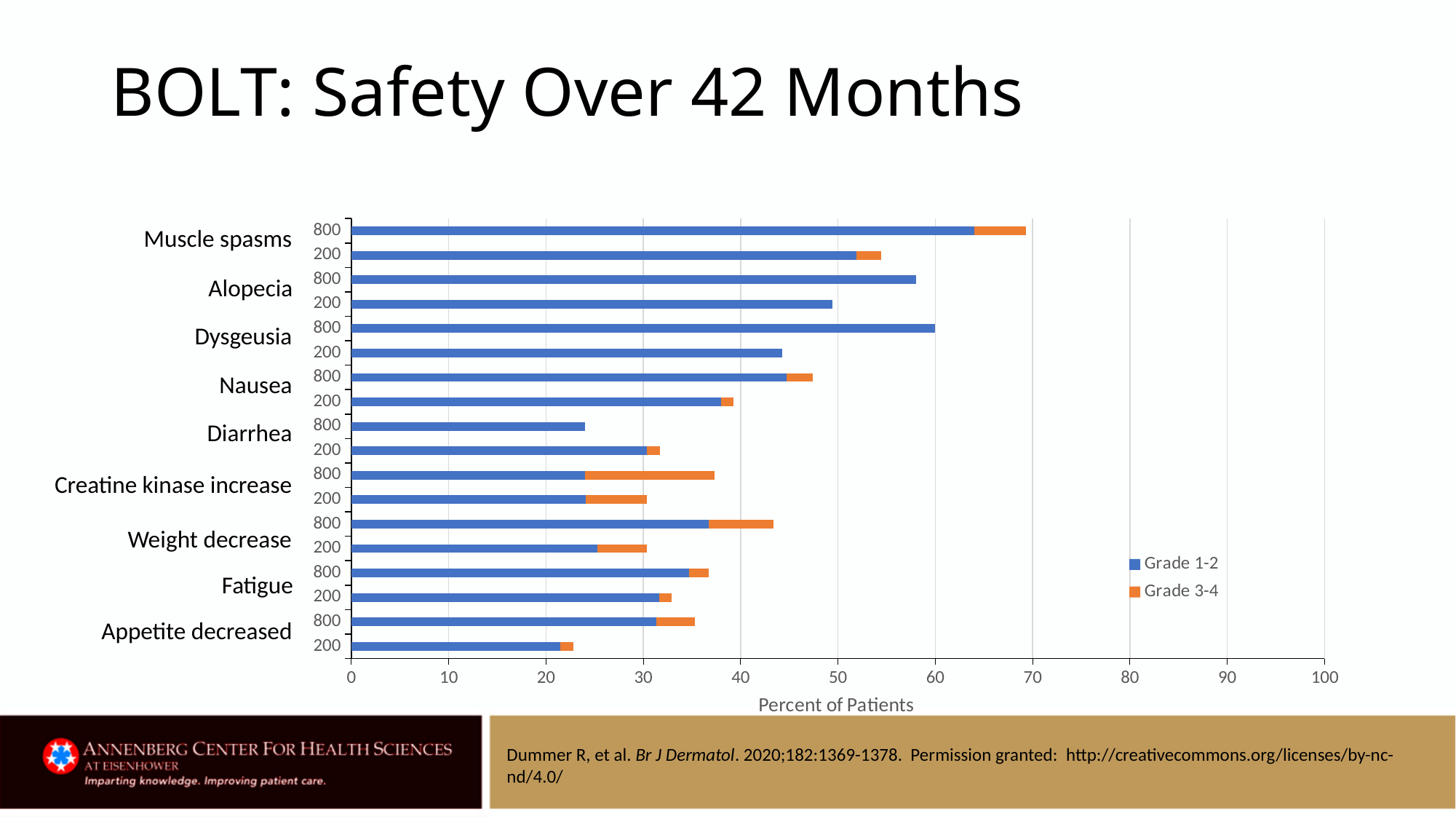
Is the value for Dysgeusia at the 800 dose greater or less than 50? greater What kind of chart is shown on the slide? bar chart Is the value for Diarrhea at the 800 dose greater or less than 30? less For Alopecia, which dose has the larger percent of patients, 800 or 200? 800 Which has the larger Grade 3-4 segment: Creatine kinase increase at 800 or Nausea at 800? Creatine kinase increase at 800 Which bar reaches the highest total percent of patients? Muscle spasms, 800 What are the two legend entries in the chart? Grade 1-2 and Grade 3-4 What is the title of the horizontal axis? Percent of Patients Is the total bar for Appetite decreased at the 200 dose greater or less than 30? less How many series does the legend list? 2 How many adverse event categories are listed on the vertical axis? 9